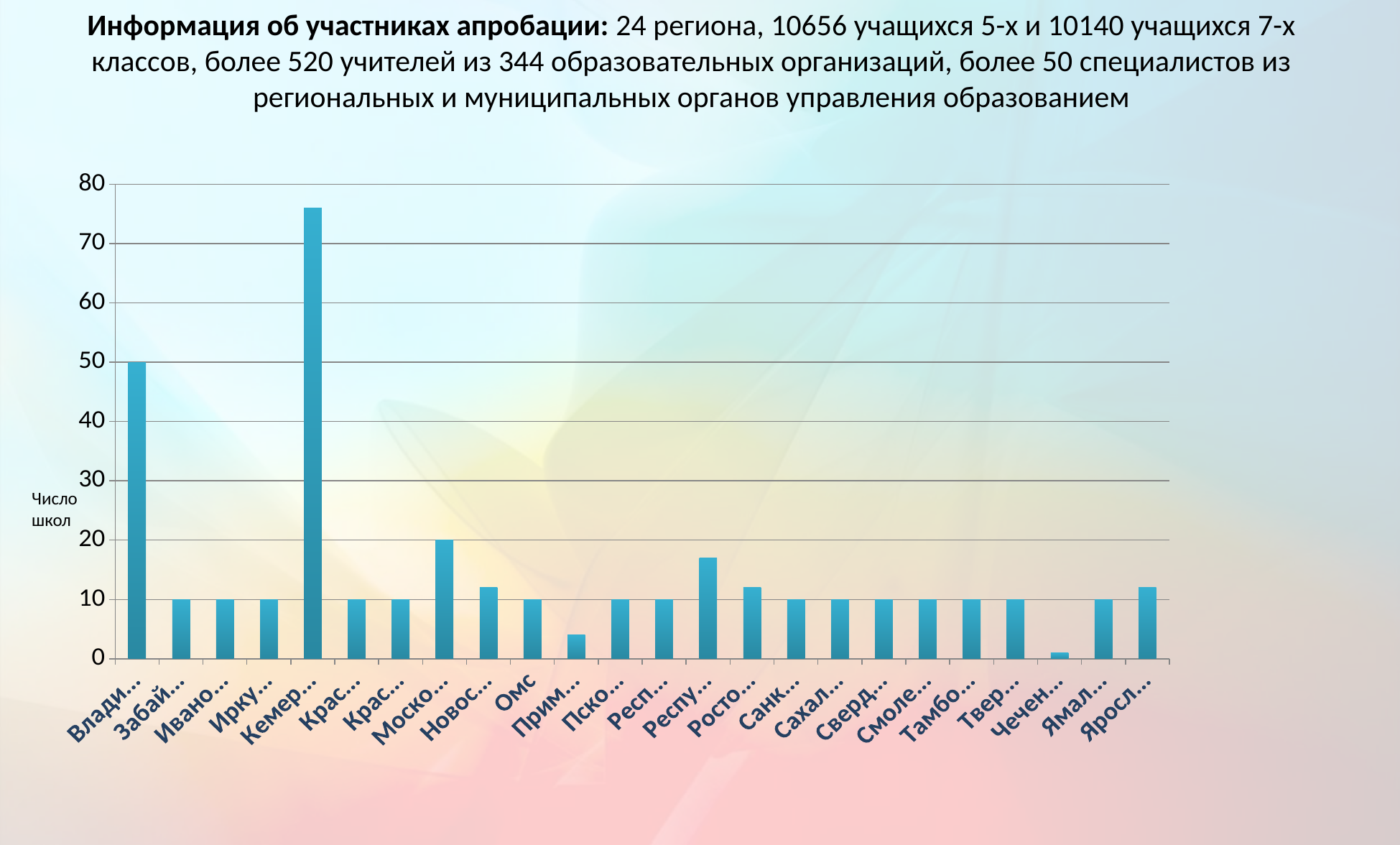
Which region has the lowest bar in the chart? Чечен… Which region has the highest bar in the chart? Кемер… What is the label on the vertical axis of the chart? Число школ Which is larger, the value for Влади… or the value for Моско…? Влади… How many regions (bars) are plotted in the chart? 24 What is the value for Влади… (the first bar)? 50 Is the value for Прим… greater or less than 10? less What kind of chart is shown on the slide? bar chart What is the value for Моско…? 20 What is the value for Омс? 10 Is the value for Кемер… greater or less than 70? greater Is the value for Респу… greater or less than 20? less